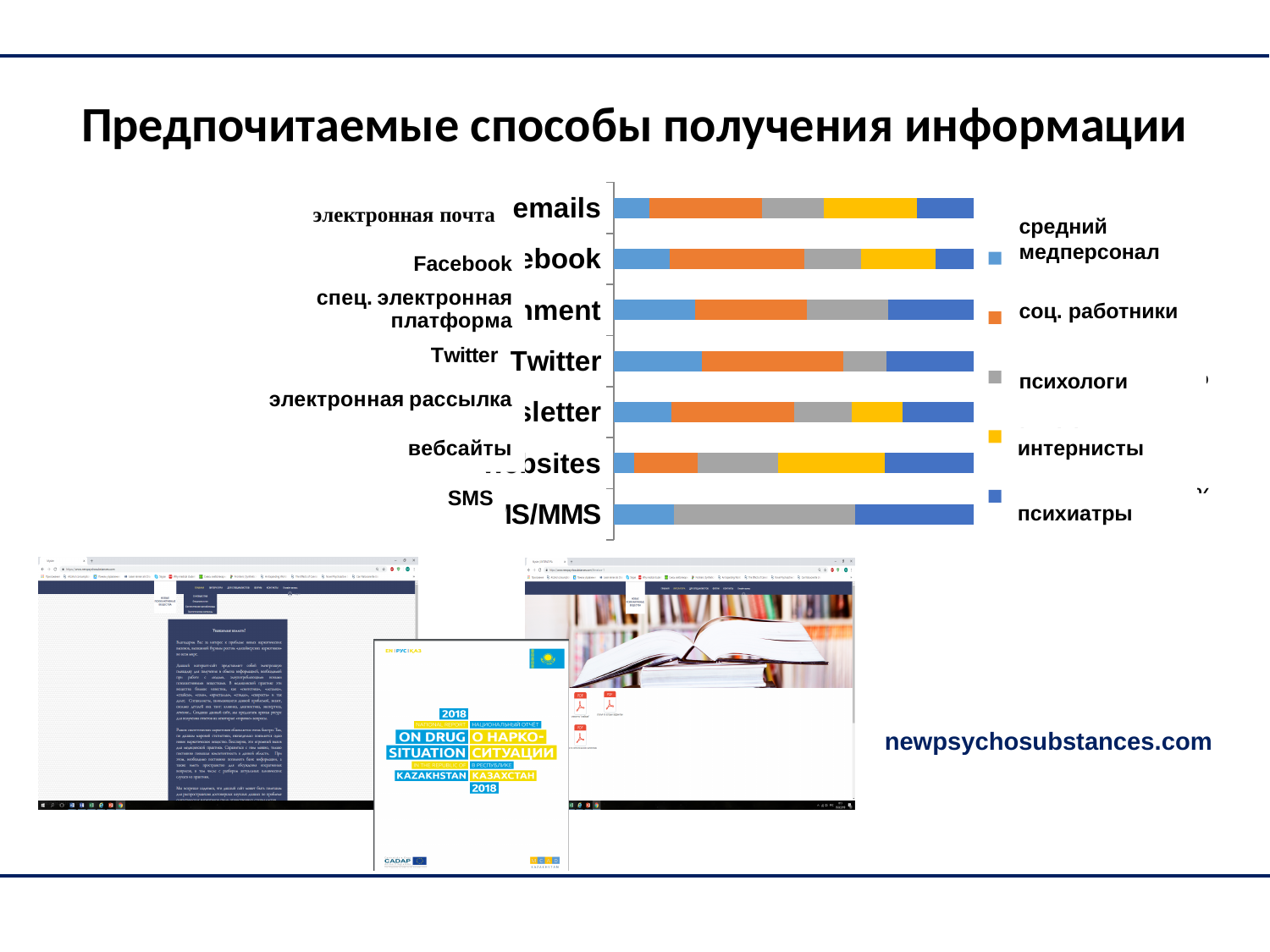
What is the title of the slide containing the chart? Предпочитаемые способы получения информации Which series is shown in orange in the chart legend? соц. работники How many series does the chart legend list? 5 How many categories (information channels) are plotted in the chart? 7 In the вебсайты bar, which series has the smallest segment? средний медперсонал In the SMS bar, which series has the largest segment? психологи What kind of chart is shown on the slide? stacked bar chart